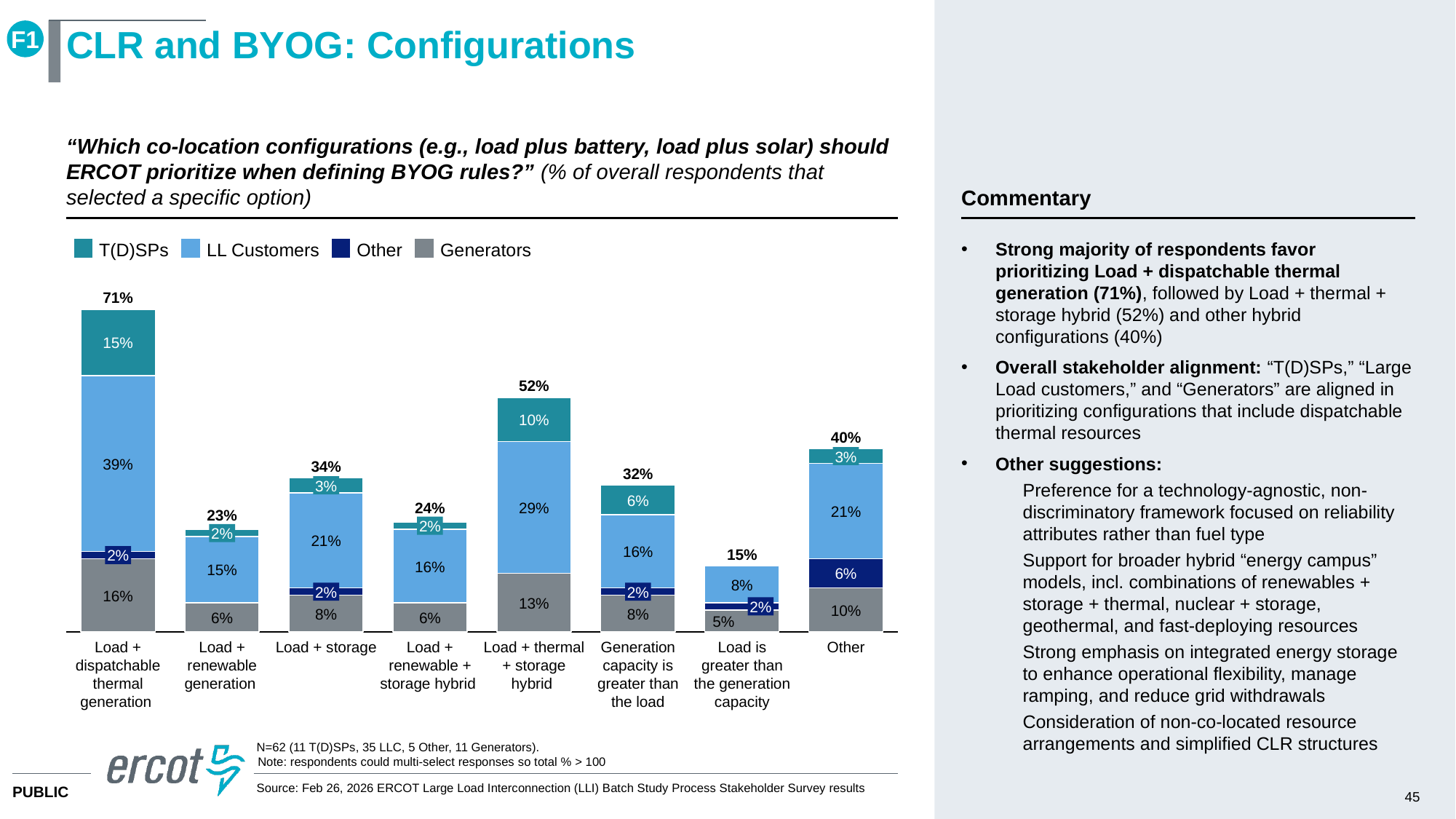
How many configuration categories are shown on the x axis? 8 What kind of chart is shown on the slide? Stacked bar chart Which legend entry is shown in gray? Generators What is the LL Customers value for Load + thermal + storage hybrid? 29% What is the Generators value for Other? 10% Which has a larger total percentage, Load + storage or Generation capacity is greater than the load? Load + storage Which configuration has the lowest total percentage? Load is greater than the generation capacity What is the T(D)SPs value for Load + dispatchable thermal generation? 15% Which configuration has the highest total percentage? Load + dispatchable thermal generation What is the difference between the total for Load + dispatchable thermal generation and the total for Load + thermal + storage hybrid? 19% How many series does the legend list? 4 What is the total percentage for Load + dispatchable thermal generation? 71%